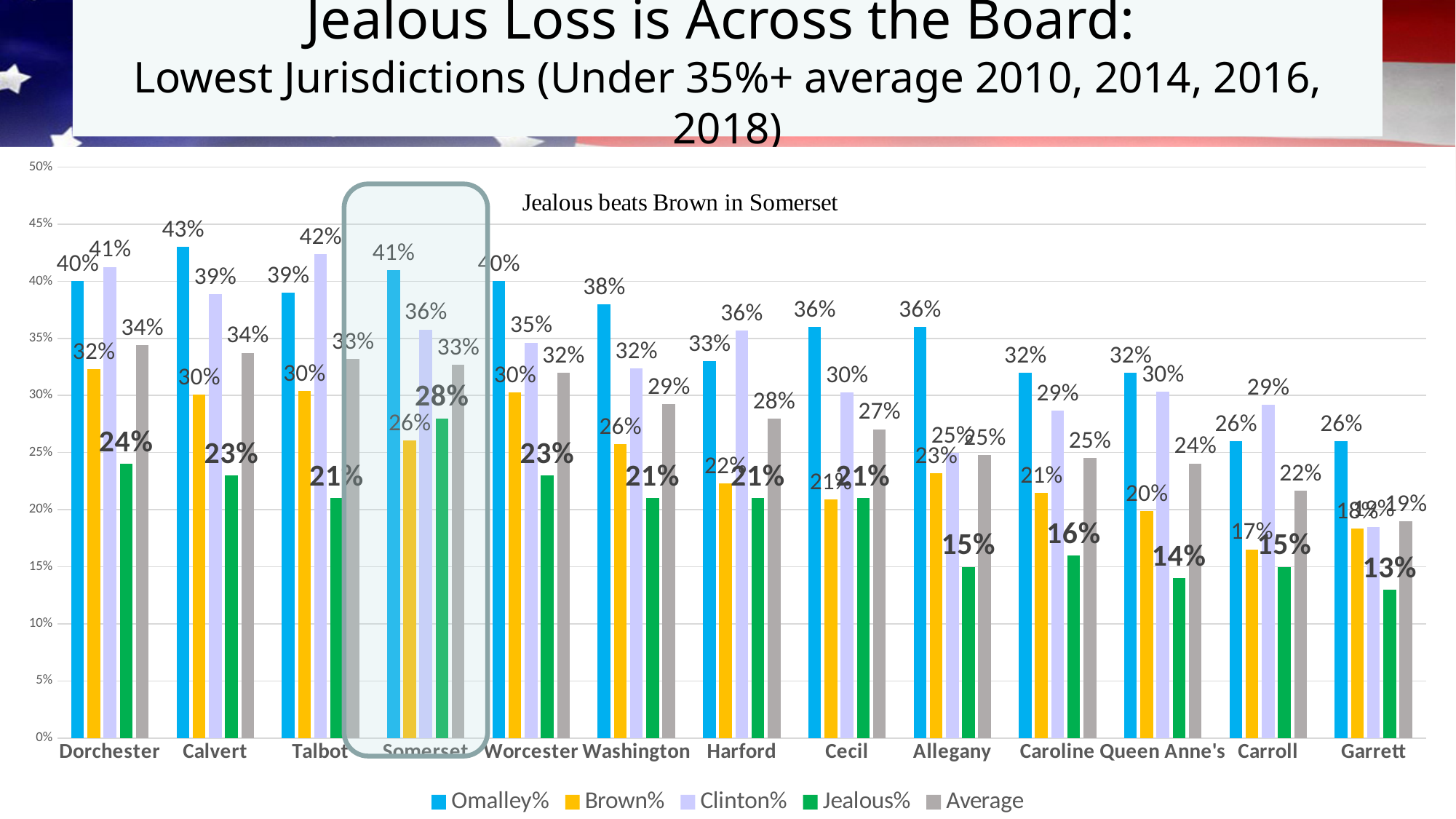
Which jurisdiction has the highest Omalley% value? Calvert What is the Jealous% value for Somerset? 28% What is the Average value for Harford? 28% What is the difference between the Omalley% and Jealous% values for Dorchester? 16 percentage points What is the Clinton% value for Talbot? 42% What kind of chart is shown on the slide? Bar chart In Somerset, which is larger: the Brown% value or the Jealous% value? Jealous% How many series does the legend list? 5 Which jurisdiction has the lowest Jealous% value? Garrett Which jurisdiction has the highest Jealous% value? Somerset What is the Omalley% value for Calvert? 43% How many jurisdictions are shown on the x axis? 13